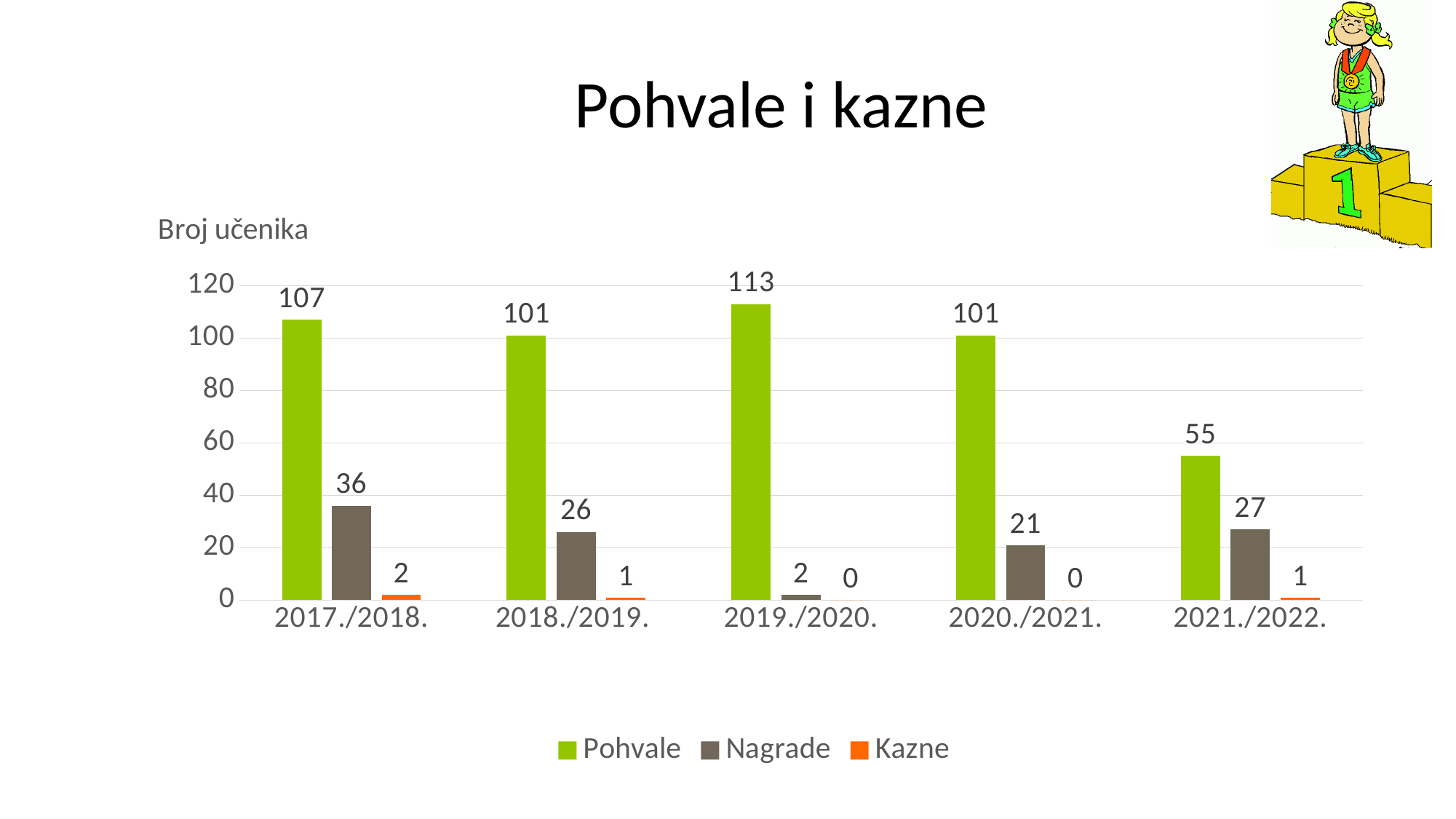
How many school years are shown on the x axis? 5 What is the difference between Pohvale in 2017./2018. and Pohvale in 2021./2022.? 52 Which school year has the highest value for Pohvale? 2019./2020. Which is larger: Nagrade in 2020./2021. or Nagrade in 2021./2022.? Nagrade in 2021./2022. What is the value of Nagrade for 2017./2018.? 36 Is the value of Pohvale for 2021./2022. greater or less than 60? less What is the value of Pohvale for 2019./2020.? 113 What is the title of the chart? Pohvale i kazne Which school year has the lowest value for Pohvale? 2021./2022. How many series does the legend list? 3 What is the value of Kazne for 2018./2019.? 1 What kind of chart is shown on the slide? bar chart